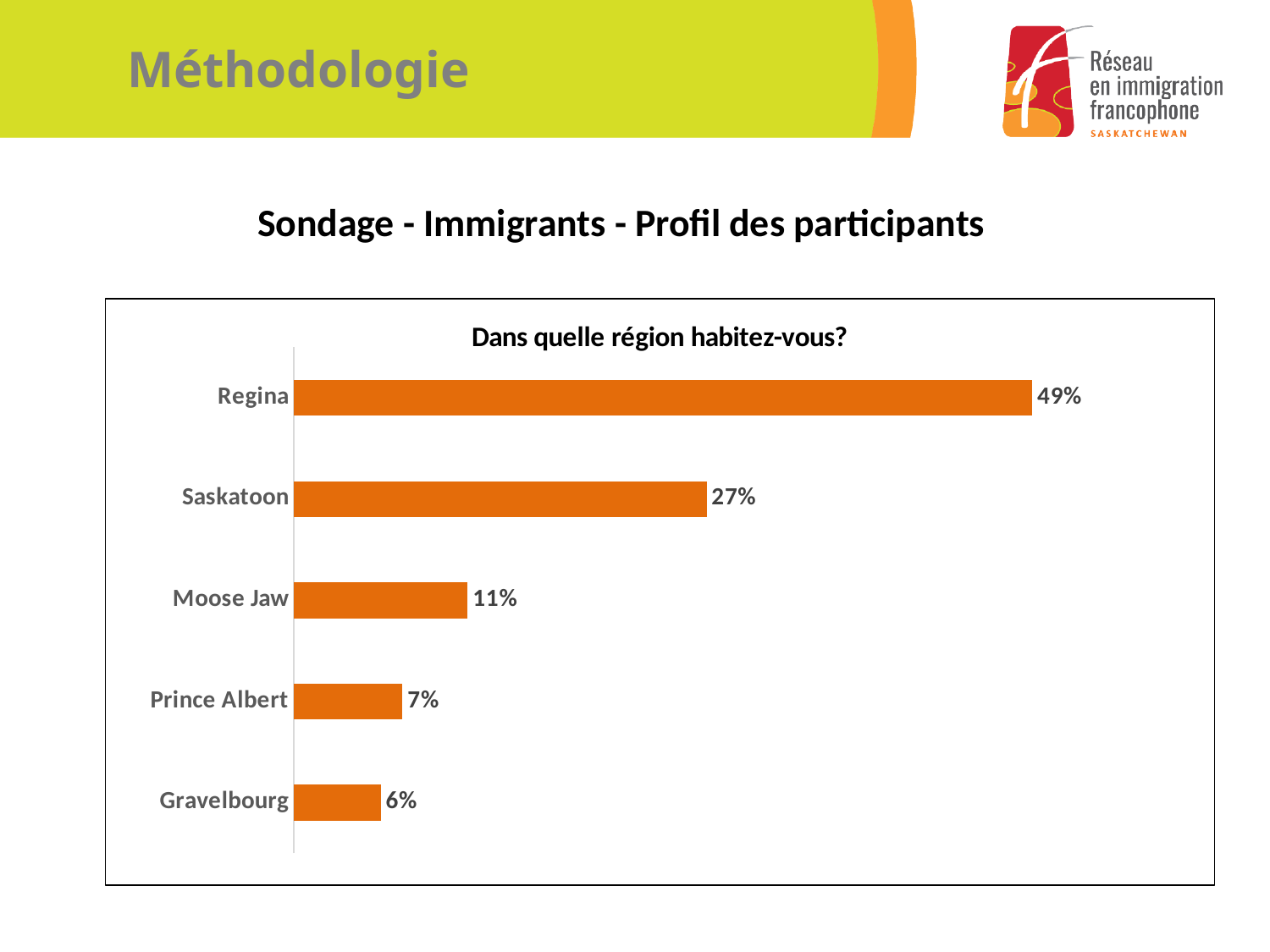
What is the difference between the values for Regina and Saskatoon? 22% How many regions are shown in the chart? 5 What kind of chart is shown on the slide? Bar chart Which region has the highest percentage of participants? Regina What is the value shown for Saskatoon? 27% Which has a larger value, Saskatoon or Moose Jaw? Saskatoon What is the value for Gravelbourg? 6% What is the title of the chart? Dans quelle région habitez-vous? What percentage is shown for Moose Jaw? 11% What percentage of participants live in Regina? 49% Which region has the lowest percentage of participants? Gravelbourg What is the difference between the values for Moose Jaw and Prince Albert? 4%